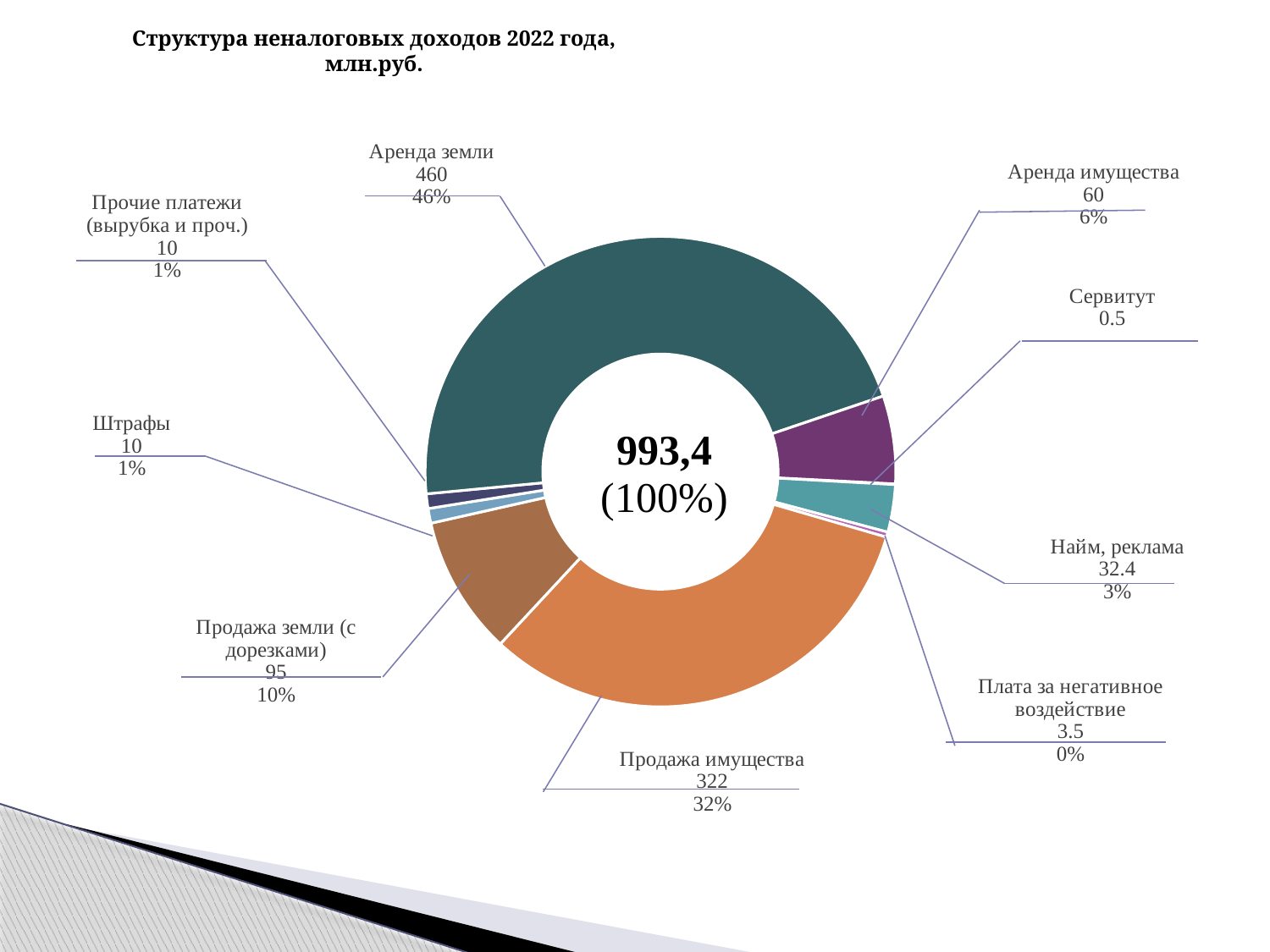
What is the value for Сервитут? 0.5 What is the value for Продажа имущества? 322 What total value is shown in the centre of the chart? 993,4 Which is larger, Аренда имущества or Продажа земли (с дорезками)? Продажа земли (с дорезками) What is the value for Аренда земли? 460 What is the difference between Аренда земли and Продажа имущества? 138 Which category has the largest value? Аренда земли What kind of chart is shown on the slide? Pie (doughnut) chart Which category has the smallest value? Сервитут What share of the total does Продажа имущества represent? 32% How many categories does the chart show? 9 What is the value for Найм, реклама? 32.4